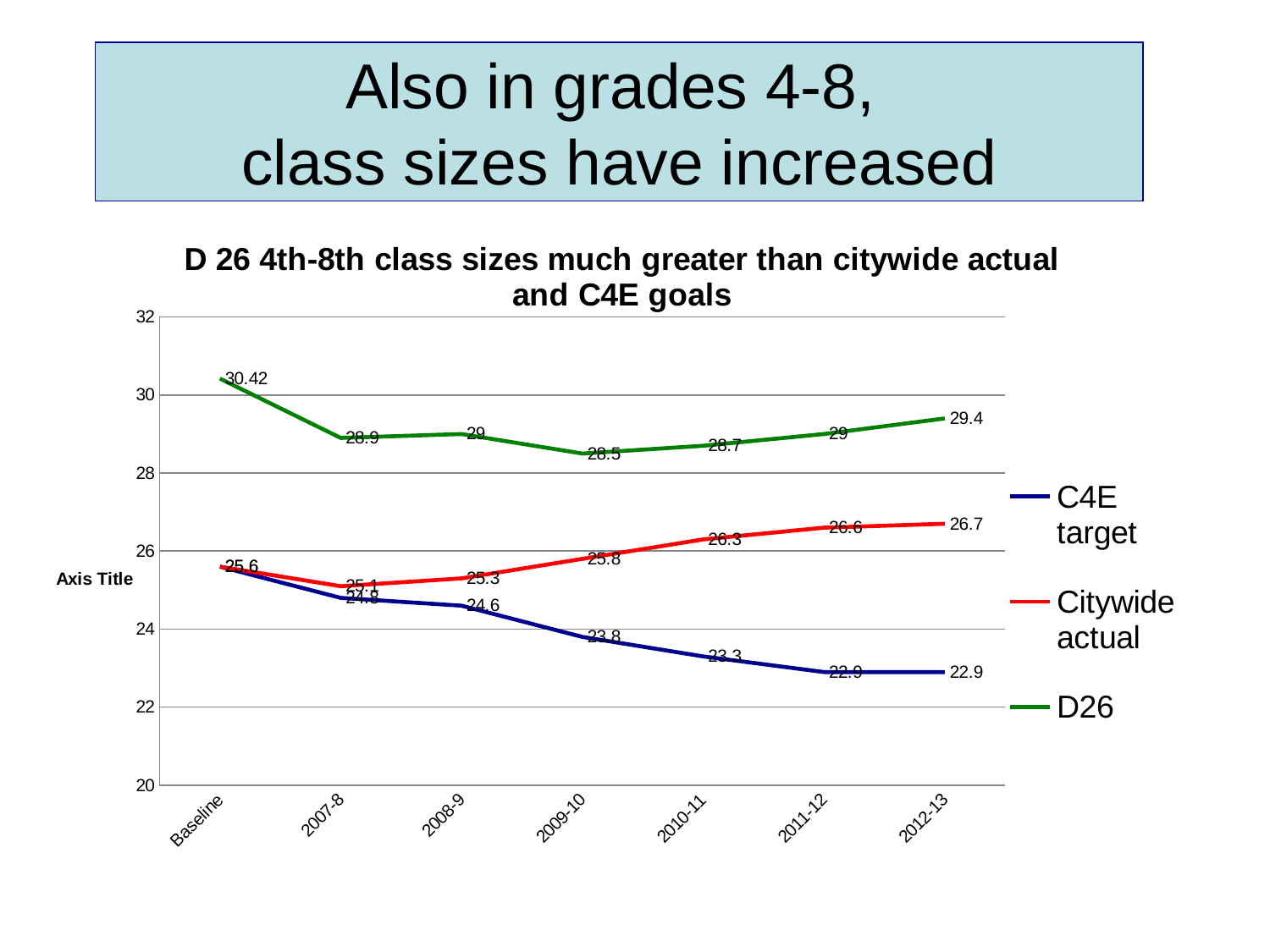
Does the C4E target series rise or fall from Baseline to 2012-13? fall How many points are plotted along the x axis for each series? 7 How many series does the legend list? 3 In which year is the D26 value lowest? 2009-10 In 2010-11, which is larger: Citywide actual or C4E target? Citywide actual What is the C4E target value for 2012-13? 22.9 What kind of chart is shown on the slide? line chart What is the difference between the D26 value and the Citywide actual value in 2012-13? 2.7 What is the Citywide actual value for 2012-13? 26.7 Is the D26 value for 2011-12 greater or less than 28? greater What is the D26 value at Baseline? 30.42 In which year is the D26 value highest? Baseline